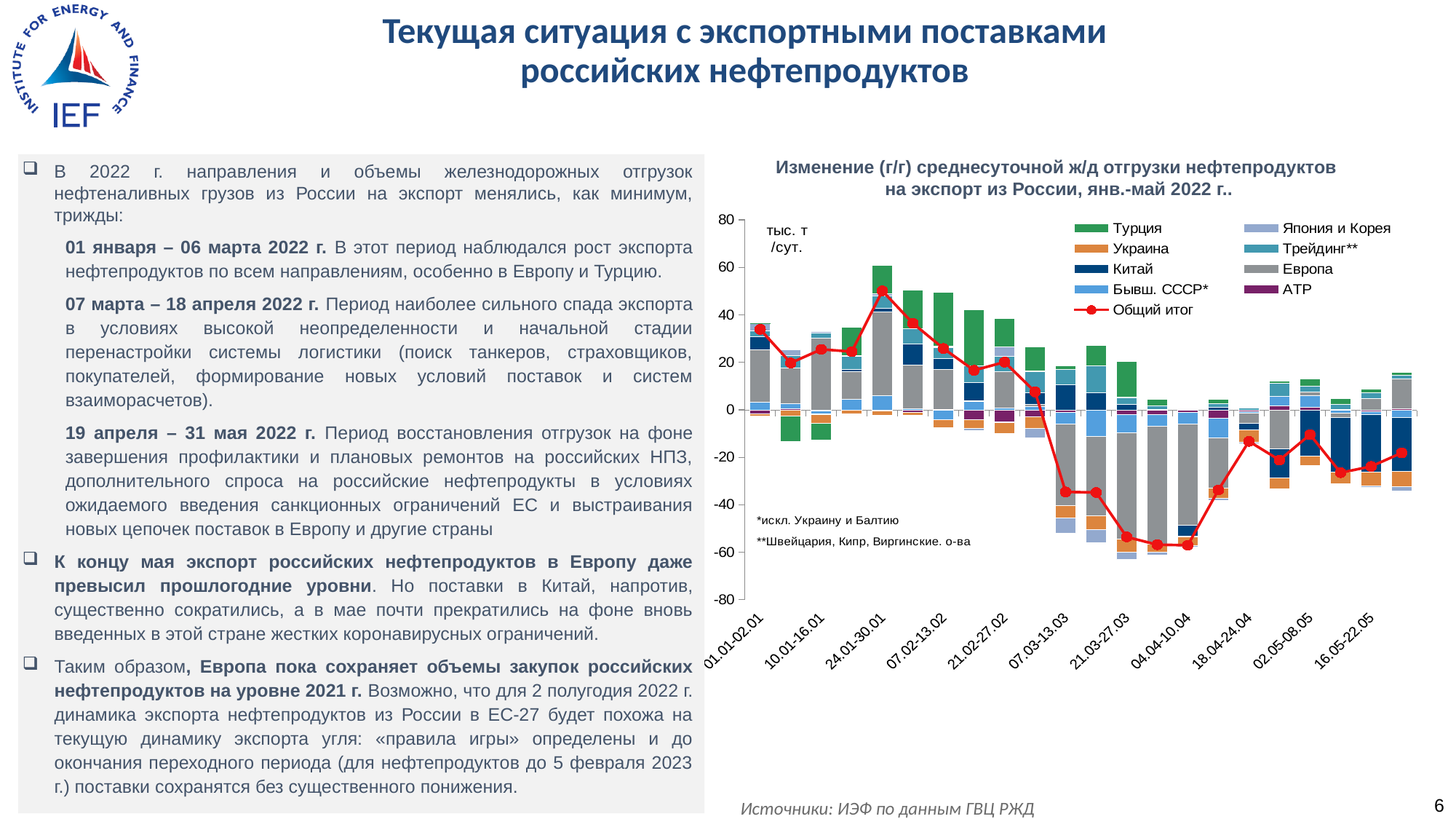
In which labelled week does the Общий итог line reach its highest value? 24.01-30.01 Is the value of Общий итог for 01.01-02.01 greater or less than 20? greater What kind of chart is shown on the slide? Stacked bar chart with a line How many series does the chart legend list? 9 What unit is shown on the chart's vertical axis? тыс. т/сут. Which is larger, the Общий итог value for 24.01-30.01 or for 21.03-27.03? 24.01-30.01 How many week labels are shown on the x axis? 11 Is the value of Общий итог for 21.03-27.03 greater or less than -40? less Is the value of Общий итог for 07.03-13.03 greater or less than -20? less Which legend entry is plotted as a red line with markers? Общий итог Does the Общий итог line rise or fall between 24.01-30.01 and 21.03-27.03? fall